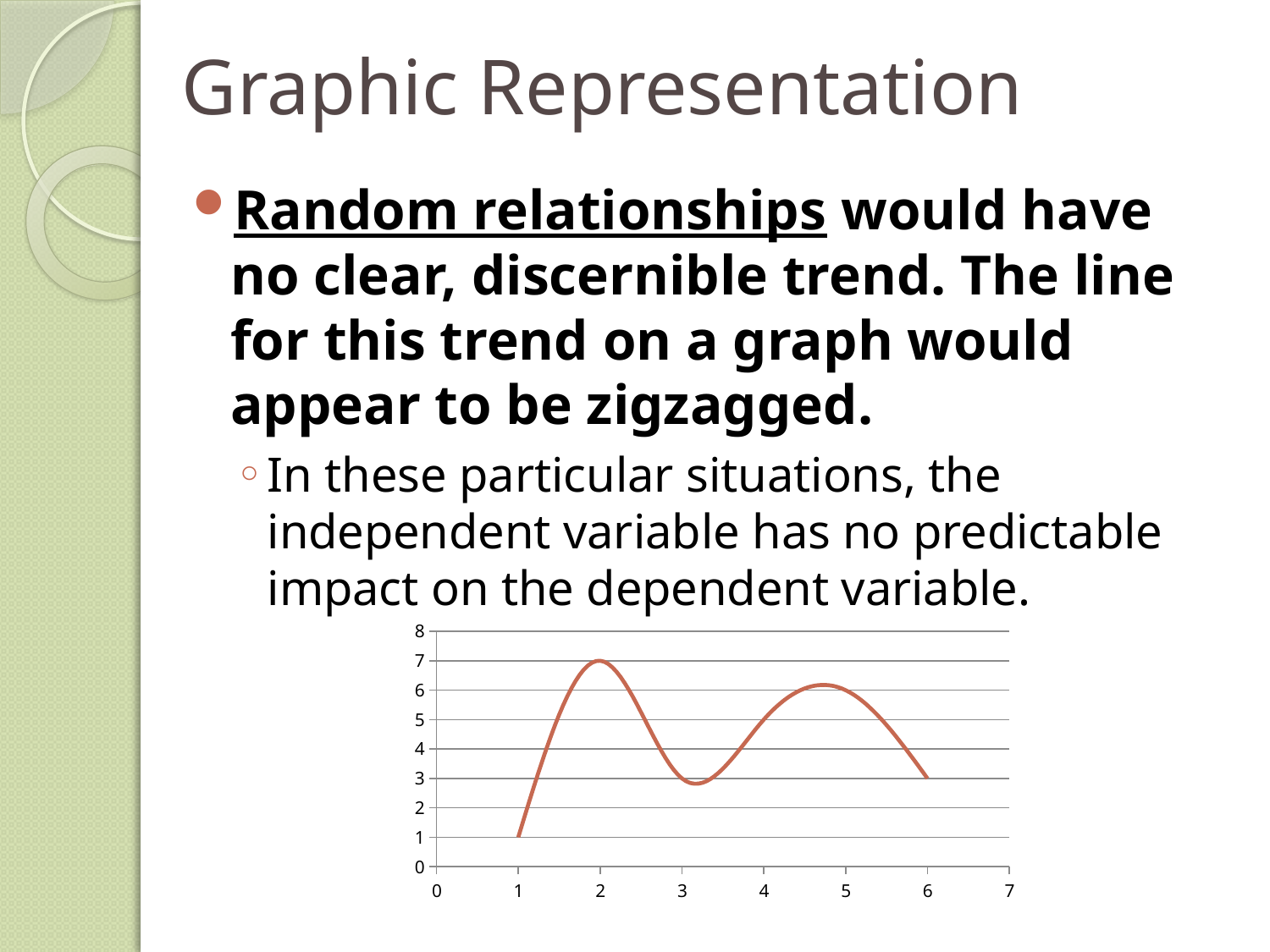
What is the y value of the line at x = 1? 1 At which x value does the line reach its highest y value? 2 At which x value does the line have its lowest y value? 1 What is the highest value shown on the y axis? 8 What is the y value of the line at x = 2? 7 Which has the larger y value, x = 2 or x = 6? x = 2 Does the line show a steady rise, a steady fall, or no clear trend along the x axis? no clear trend Is the y value of the line at x = 3 greater or less than 4? less What kind of chart is shown on the slide? line chart What is the y value of the line at x = 6? 3 What is the difference between the y value at x = 2 and the y value at x = 1? 6 Is the y value of the line at x = 5 greater or less than 5? greater